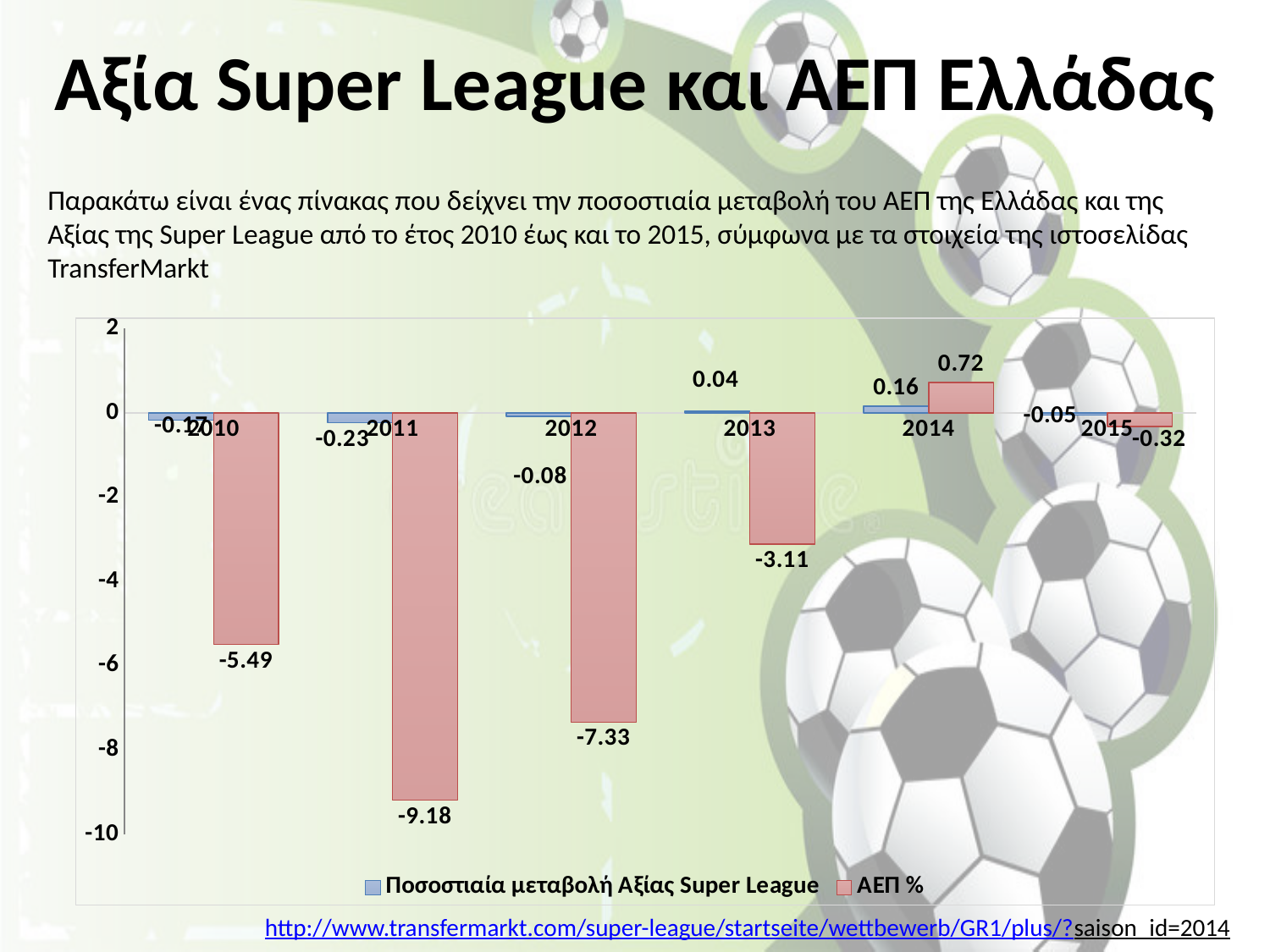
What is the value of Ποσοστιαία μεταβολή Αξίας Super League for 2014? 0.16 What is the value of ΑΕΠ % for 2011? -9.18 Which year has the larger ΑΕΠ % value, 2010 or 2012? 2010 What is the value of ΑΕΠ % for 2015? -0.32 How many series does the chart legend list? 2 In which year is Ποσοστιαία μεταβολή Αξίας Super League highest? 2014 In which year is ΑΕΠ % lowest? 2011 In which year is ΑΕΠ % highest? 2014 What is the difference between ΑΕΠ % in 2012 and in 2013? 4.22 What kind of chart is shown on the slide? Bar chart Which series is shown in red in the chart? ΑΕΠ % How many years are shown on the x axis of the chart? 6